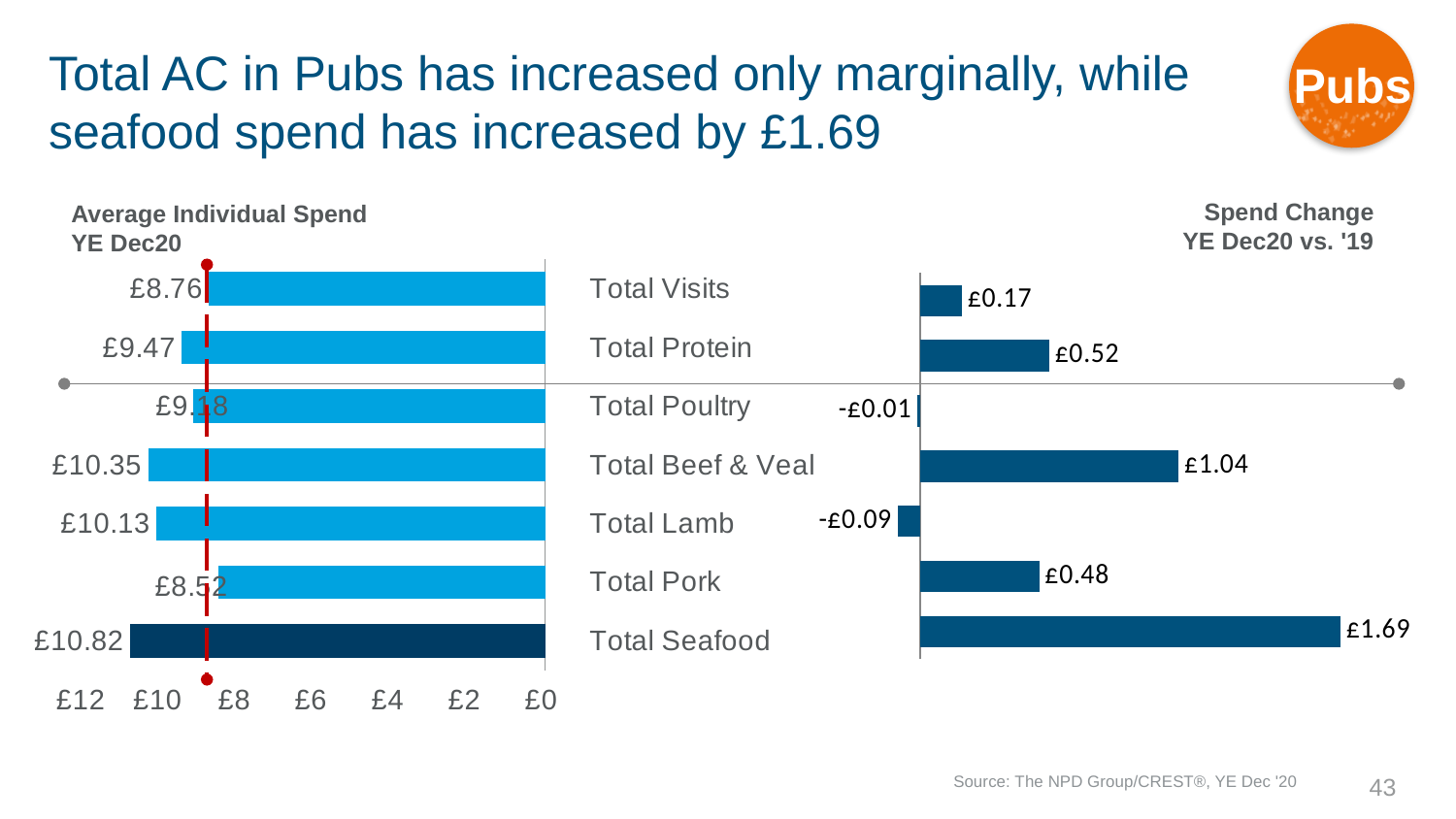
On the Spend Change YE Dec20 vs. '19 chart, which category has the lowest value? Total Lamb On the Average Individual Spend YE Dec20 chart, what is the value for Total Beef & Veal? £10.35 On the Spend Change YE Dec20 vs. '19 chart, what is the value for Total Seafood? £1.69 On the Spend Change YE Dec20 vs. '19 chart, which is larger, Total Protein or Total Pork? Total Protein On the Average Individual Spend YE Dec20 chart, what is the value for Total Seafood? £10.82 On the Average Individual Spend YE Dec20 chart, which category has the highest value? Total Seafood On the Spend Change YE Dec20 vs. '19 chart, what is the value for Total Lamb? -£0.09 What kind of chart is the Average Individual Spend YE Dec20 chart? Bar chart How many categories are shown on the Spend Change YE Dec20 vs. '19 chart? 7 On the Average Individual Spend YE Dec20 chart, what is the value for Total Visits? £8.76 On the Spend Change YE Dec20 vs. '19 chart, what is the value for Total Beef & Veal? £1.04 On the Average Individual Spend YE Dec20 chart, what is the difference between Total Beef & Veal and Total Lamb? £0.22